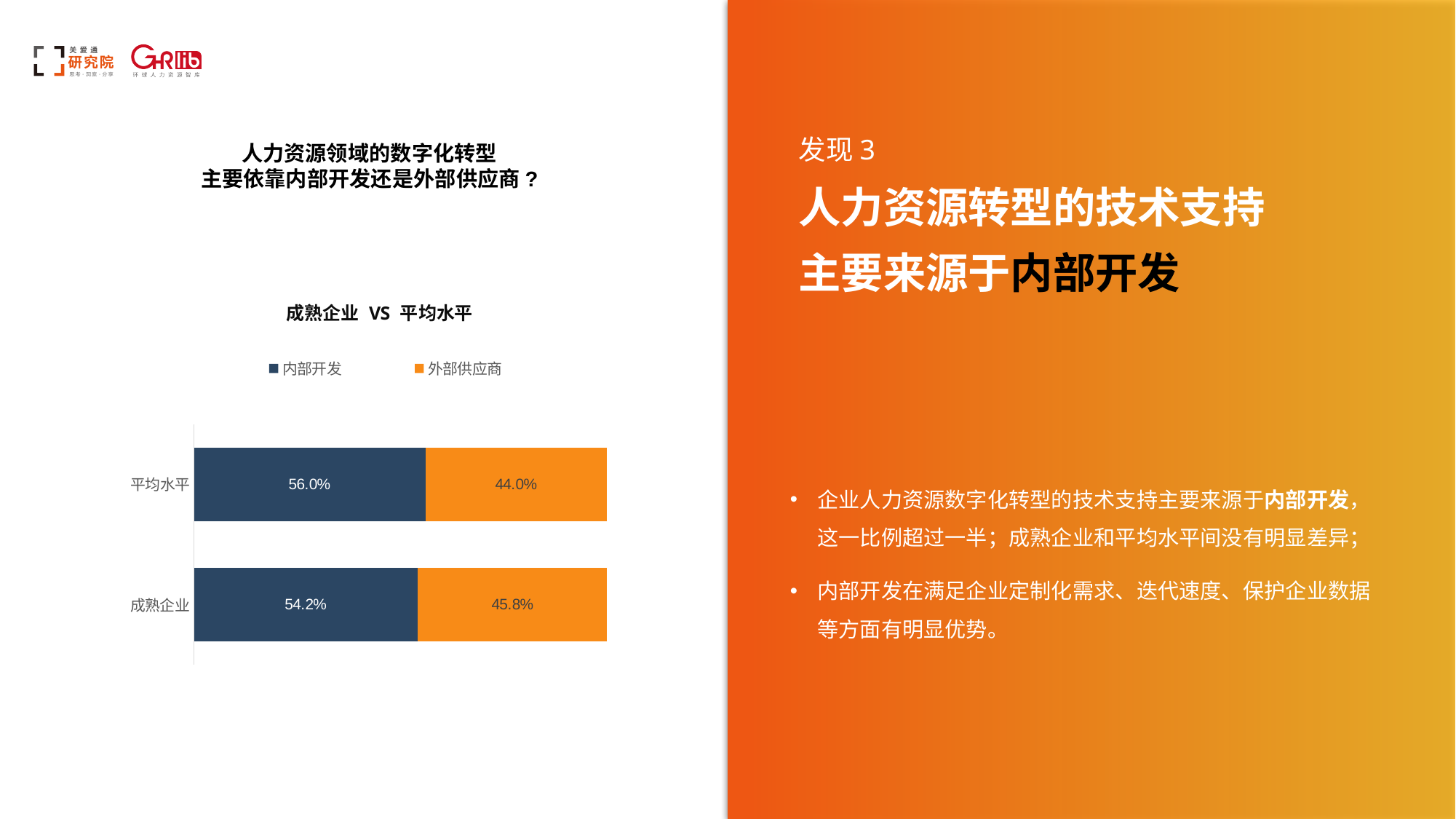
Which colour represents 外部供应商 in the chart? Orange What is the value for 外部供应商 in the 成熟企业 bar? 45.8% What is the value for 内部开发 in the 平均水平 bar? 56.0% What is the value for 内部开发 in the 成熟企业 bar? 54.2% What kind of chart is shown on the slide? Stacked bar chart How many series does the legend list? 2 What is the difference between 内部开发 and 外部供应商 in the 成熟企业 bar? 8.4% Which category has the higher 内部开发 share, 平均水平 or 成熟企业? 平均水平 What is the difference between the 内部开发 values for 平均水平 and 成熟企业? 1.8% How many categories are shown on the chart? 2 What is the total of the 平均水平 stacked bar? 100.0% What is the value for 外部供应商 in the 平均水平 bar? 44.0%